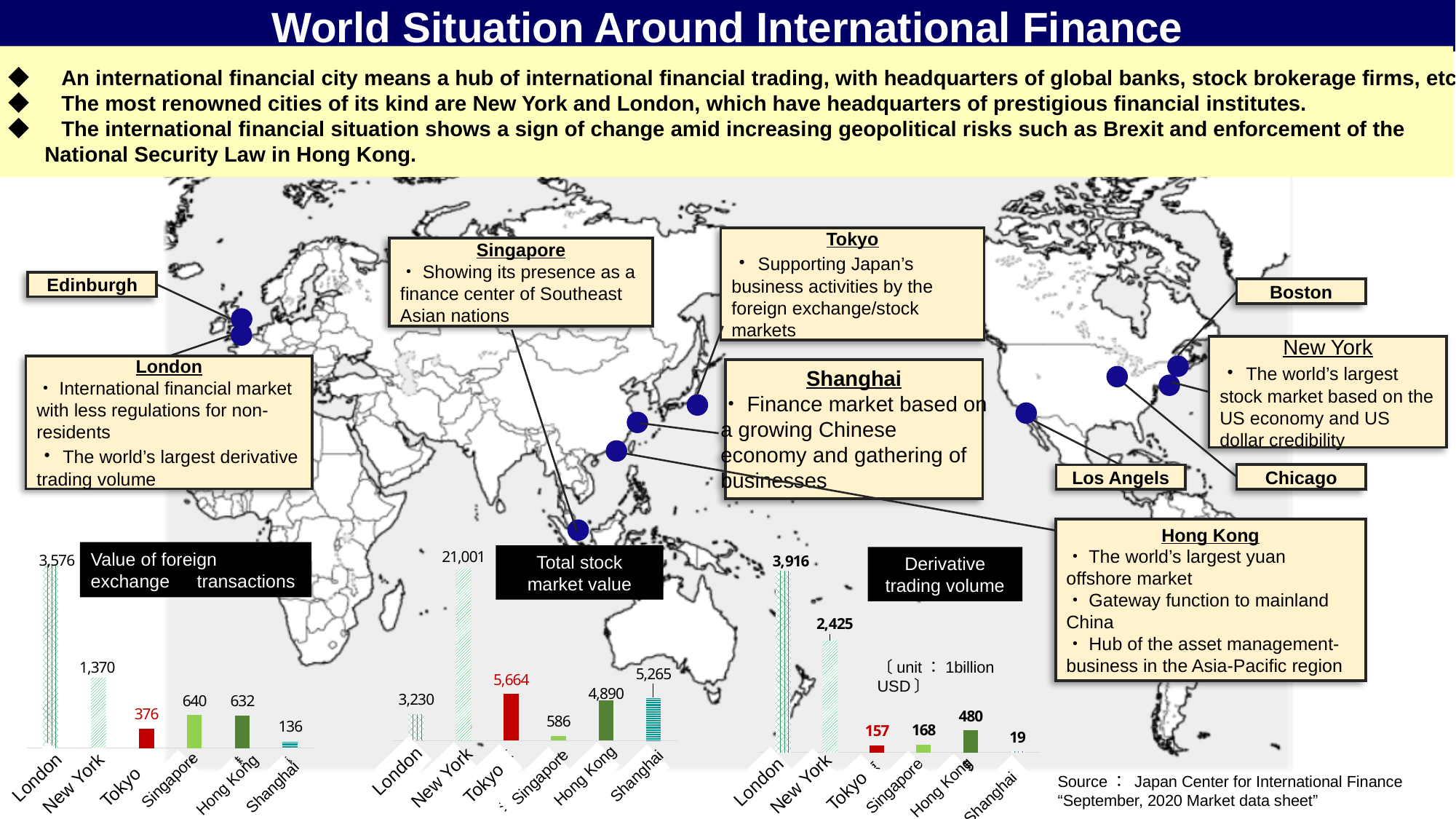
In the 'Derivative trading volume' chart, which city has the highest value? London How many cities are shown in the 'Derivative trading volume' chart? 6 In the 'Derivative trading volume' chart, what is the difference between the values for London and New York? 1,491 In the 'Total stock market value' chart, what is the value for New York? 21,001 In the 'Total stock market value' chart, what is the value for Singapore? 586 In the 'Total stock market value' chart, which is larger, the value for Tokyo or the value for Hong Kong? Tokyo In the 'Total stock market value' chart, which city has the highest value? New York In the 'Value of foreign exchange transactions' chart, which city has the lowest value? Shanghai In the 'Value of foreign exchange transactions' chart, what is the value for London? 3,576 In the 'Derivative trading volume' chart, what is the value for Hong Kong? 480 What type of chart is the 'Total stock market value' chart? Bar chart In the 'Value of foreign exchange transactions' chart, what is the difference between the values for New York and Tokyo? 994